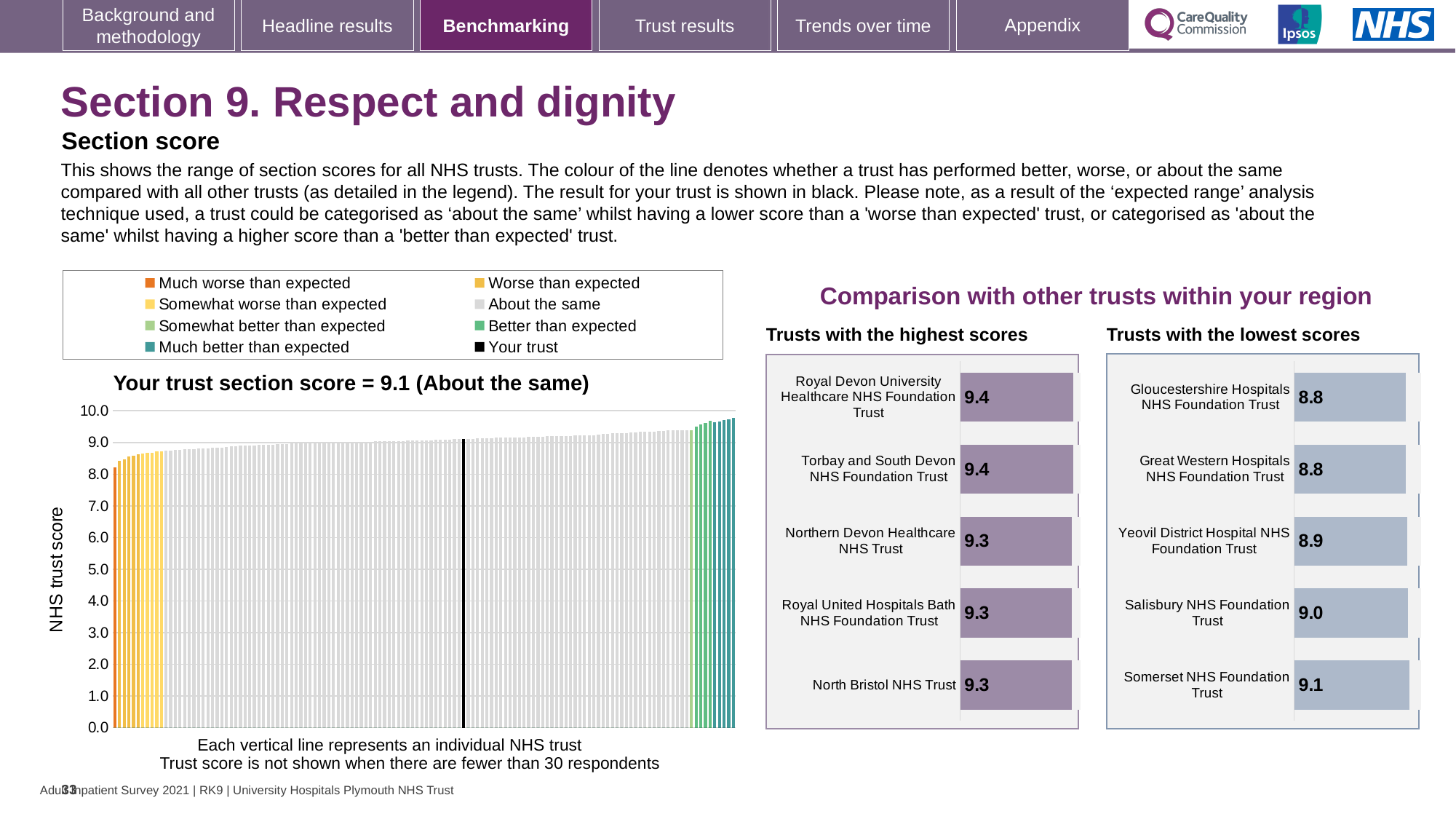
On the 'Trusts with the lowest scores' chart, which trust has the highest score? Somerset NHS Foundation Trust How many trusts are listed on the 'Trusts with the highest scores' chart? 5 On the 'Your trust section score' chart, do the bar values rise or fall from left to right along the x axis? Rise On the 'Your trust section score' chart, is the value of the lowest-scoring trust greater or less than 9.0? less According to the title of the left chart, what is your trust's section score? 9.1 (About the same) How many entries does the legend above the 'Your trust section score' chart list? 8 On the 'Trusts with the highest scores' chart, what is the score for Royal Devon University Healthcare NHS Foundation Trust? 9.4 On the 'Trusts with the lowest scores' chart, which has the larger score: Salisbury NHS Foundation Trust or Great Western Hospitals NHS Foundation Trust? Salisbury NHS Foundation Trust What type of chart is the 'Your trust section score' chart on the left? Bar chart On the 'Trusts with the lowest scores' chart, what is the difference between the scores of Somerset NHS Foundation Trust and Gloucestershire Hospitals NHS Foundation Trust? 0.3 On the 'Trusts with the highest scores' chart, what is the score for North Bristol NHS Trust? 9.3 On the 'Trusts with the lowest scores' chart, what is the score for Yeovil District Hospital NHS Foundation Trust? 8.9